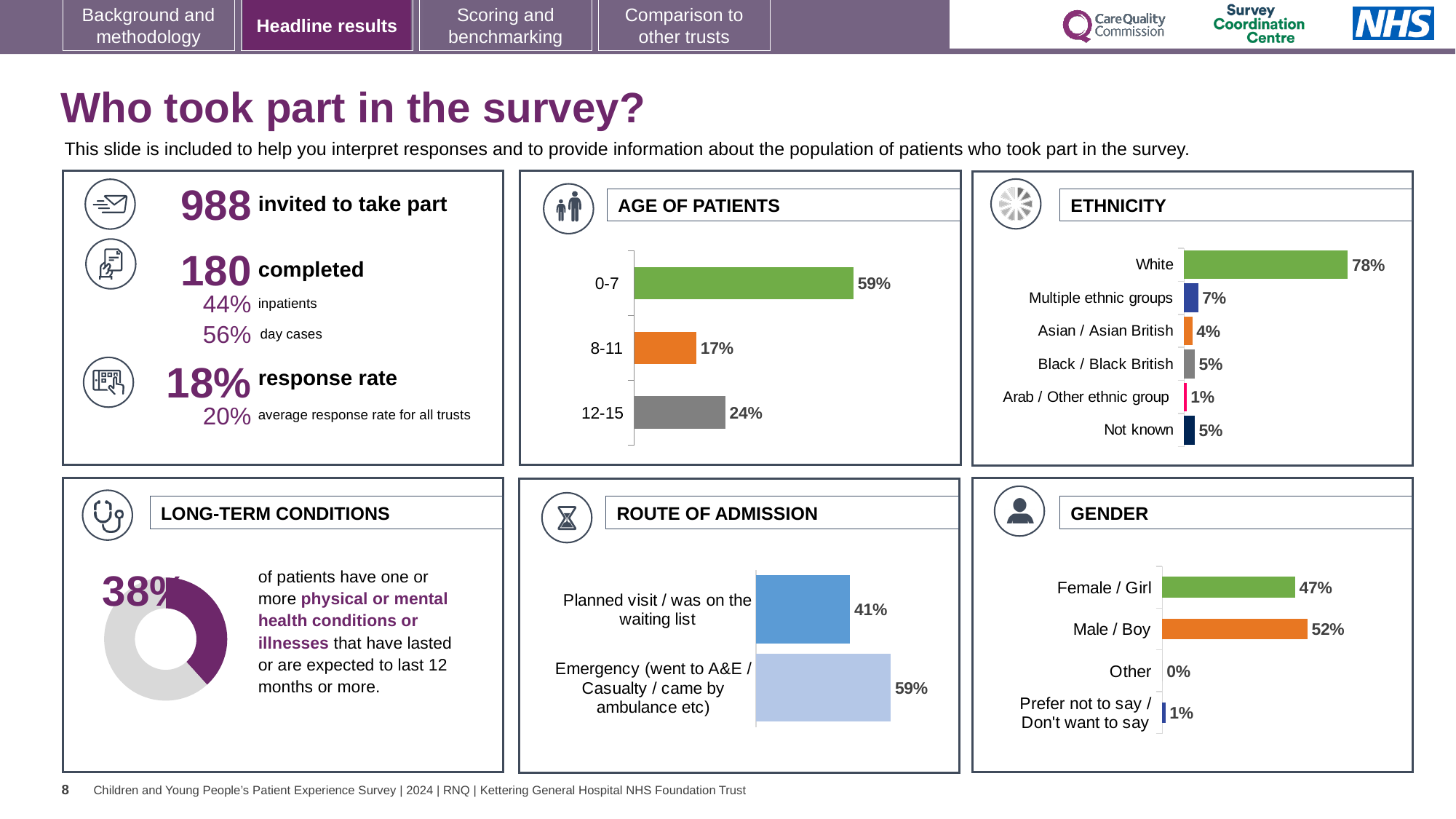
In the ROUTE OF ADMISSION chart, what is the difference between the Emergency and Planned visit percentages? 18% In the GENDER chart, which category has the highest percentage? Male / Boy In the ROUTE OF ADMISSION chart, what percentage of patients came via Emergency (went to A&E / Casualty / came by ambulance etc)? 59% In the AGE OF PATIENTS chart, what percentage of patients were aged 0-7? 59% In the AGE OF PATIENTS chart, which age group has the lowest percentage? 8-11 How many categories are shown in the ETHNICITY chart? 6 In the GENDER chart, what percentage of patients were Male / Boy? 52% In the ETHNICITY chart, which is larger: Multiple ethnic groups or Asian / Asian British? Multiple ethnic groups In the ETHNICITY chart, what percentage of patients were White? 78% What kind of chart is used in the LONG-TERM CONDITIONS panel? Doughnut chart In the AGE OF PATIENTS chart, what is the difference between the 12-15 and 8-11 percentages? 7% In the ETHNICITY chart, which category has the lowest percentage? Arab / Other ethnic group